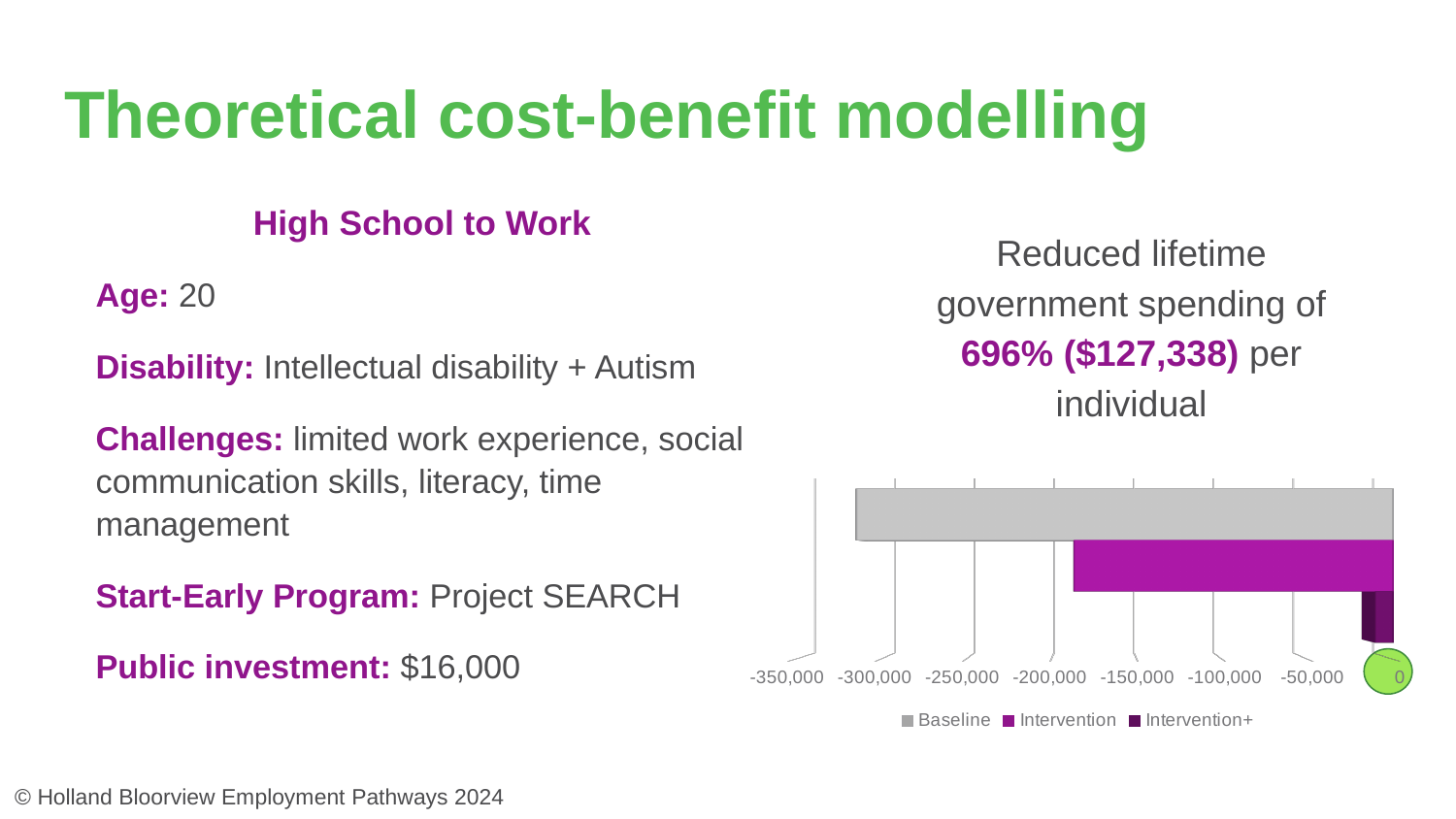
Which series has the shortest bar (the value closest to 0)? Intervention+ Is the value for Intervention greater or less than -250,000? greater Which bar extends further left, Baseline or Intervention? Baseline What are the three series named in the chart's legend? Baseline, Intervention, Intervention+ Which bar extends further left, Intervention or Intervention+? Intervention What kind of chart is shown on the slide? bar chart How many series does the chart's legend list? 3 Is the value for Baseline greater or less than -300,000? less How many bars are plotted in the chart? 3 Is the value for Intervention+ greater or less than -50,000? greater What colour is the Baseline bar in the chart? gray Which series has the bar extending furthest to the left (the largest negative value)? Baseline